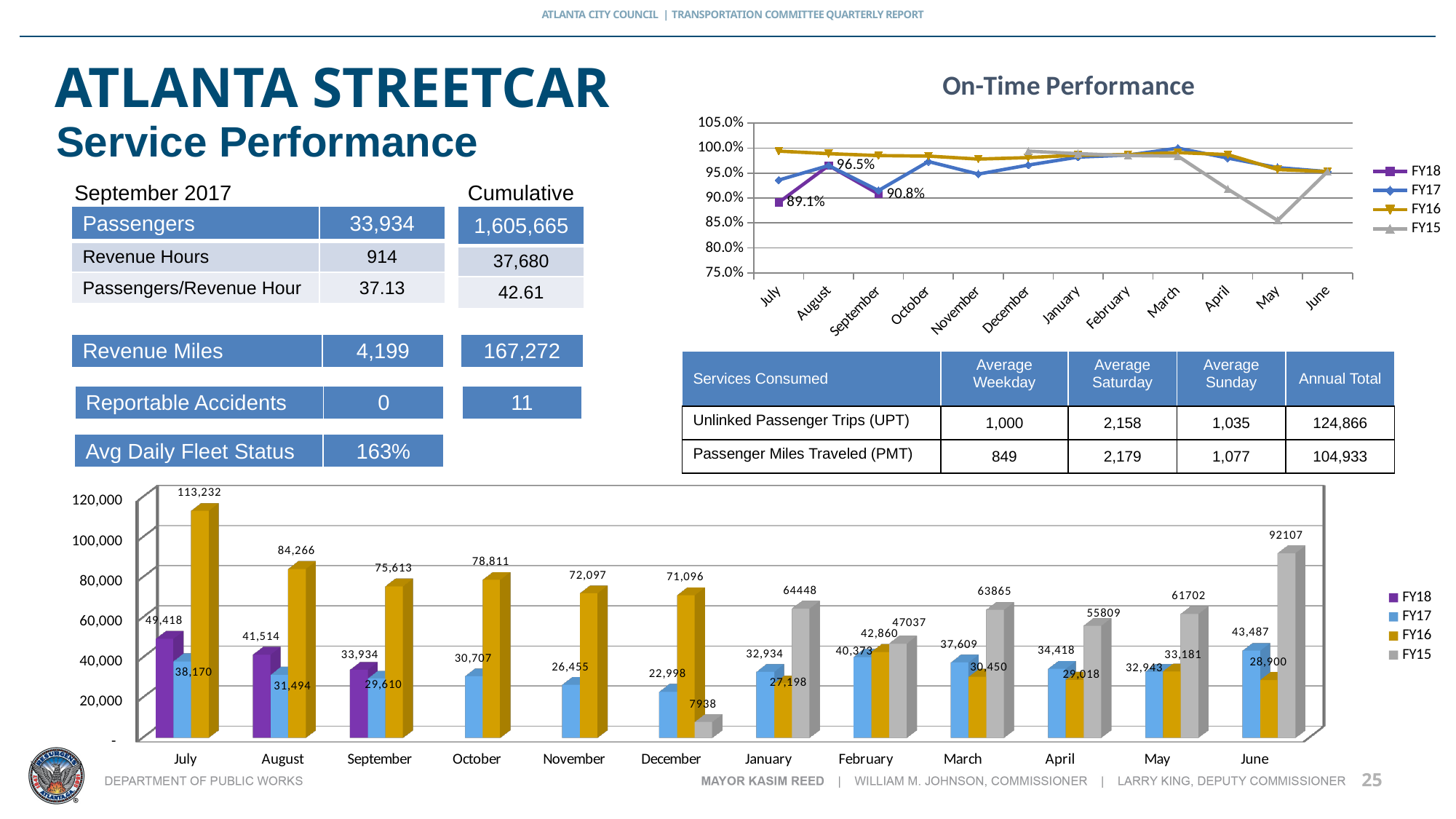
In the bottom bar chart, what is the FY18 value for September? 33,934 In the bottom bar chart, how many months are shown on the x axis? 12 In the bottom bar chart, which month has the lowest FY15 value? December What kind of chart is the On-Time Performance chart? Line chart In the bottom bar chart, how many series does the legend list? 4 In the On-Time Performance chart, is the FY15 value for May greater or less than 90.0%? less In the bottom bar chart, what is the difference between the FY18 and FY17 values for July? 11,248 In the bottom bar chart, which month has the highest FY16 value? July In the bottom bar chart, what is the FY16 value for July? 113,232 In the On-Time Performance chart, which month has the lowest FY18 value? July In the On-Time Performance chart, what is the FY18 value for August? 96.5% In the bottom bar chart, which is larger for June: FY17 or FY16? FY17